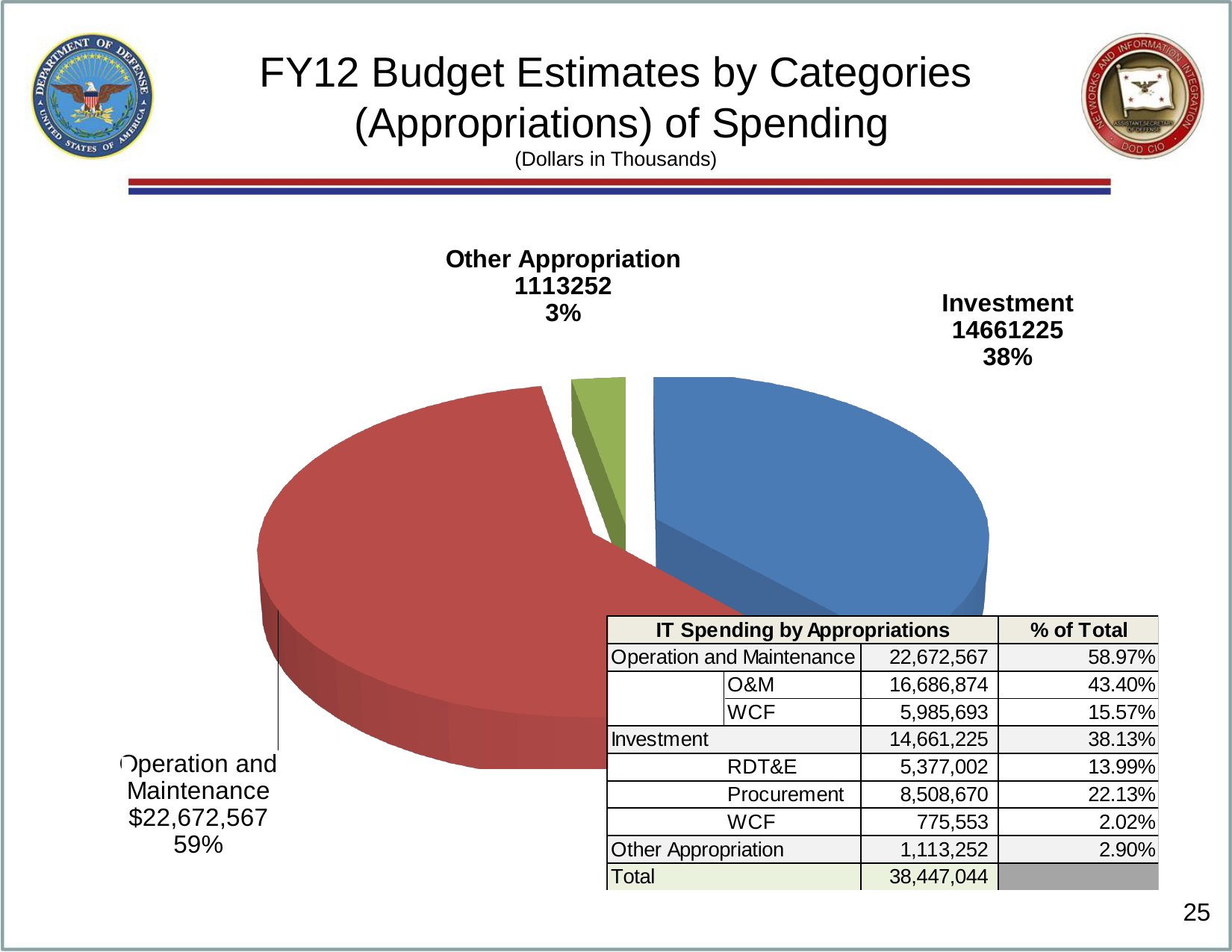
What colour is the Investment slice in the pie chart? blue What share of the pie does Operation and Maintenance represent? 59% How many slices does the pie chart have? 3 What value is shown for the Investment slice of the pie chart? 14661225 What share of the pie does Other Appropriation represent? 3% Which category has the smallest slice in the pie chart? Other Appropriation What value is shown for the Operation and Maintenance slice of the pie chart? $22,672,567 What kind of chart is shown on the slide? pie chart Which is larger in the pie chart, Investment or Other Appropriation? Investment What share of the pie does Investment represent? 38% Which category has the largest slice in the pie chart? Operation and Maintenance What value is shown for the Other Appropriation slice of the pie chart? 1113252